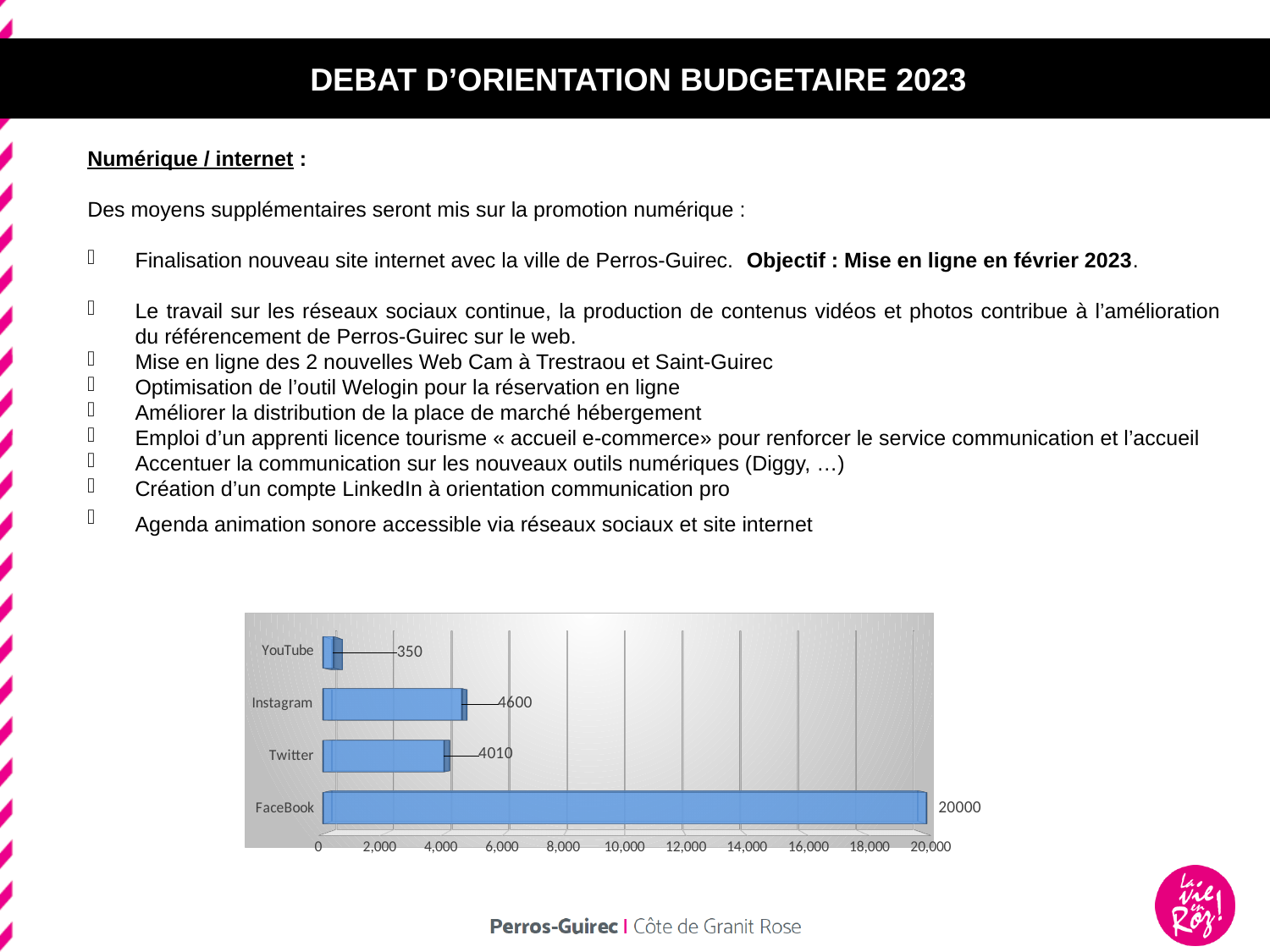
What kind of chart is shown on the slide? bar chart What is the difference between the values for Instagram and Twitter? 590 Which category has the highest value? FaceBook What is the value for Instagram? 4600 How many categories are shown in the chart? 4 What is the difference between the values for FaceBook and Instagram? 15400 What is the value for FaceBook? 20000 What is the value for Twitter? 4010 What is the value for YouTube? 350 Is the value for Twitter greater or less than 6,000? less Which category has the lowest value? YouTube Which is larger, the value for Instagram or the value for Twitter? Instagram